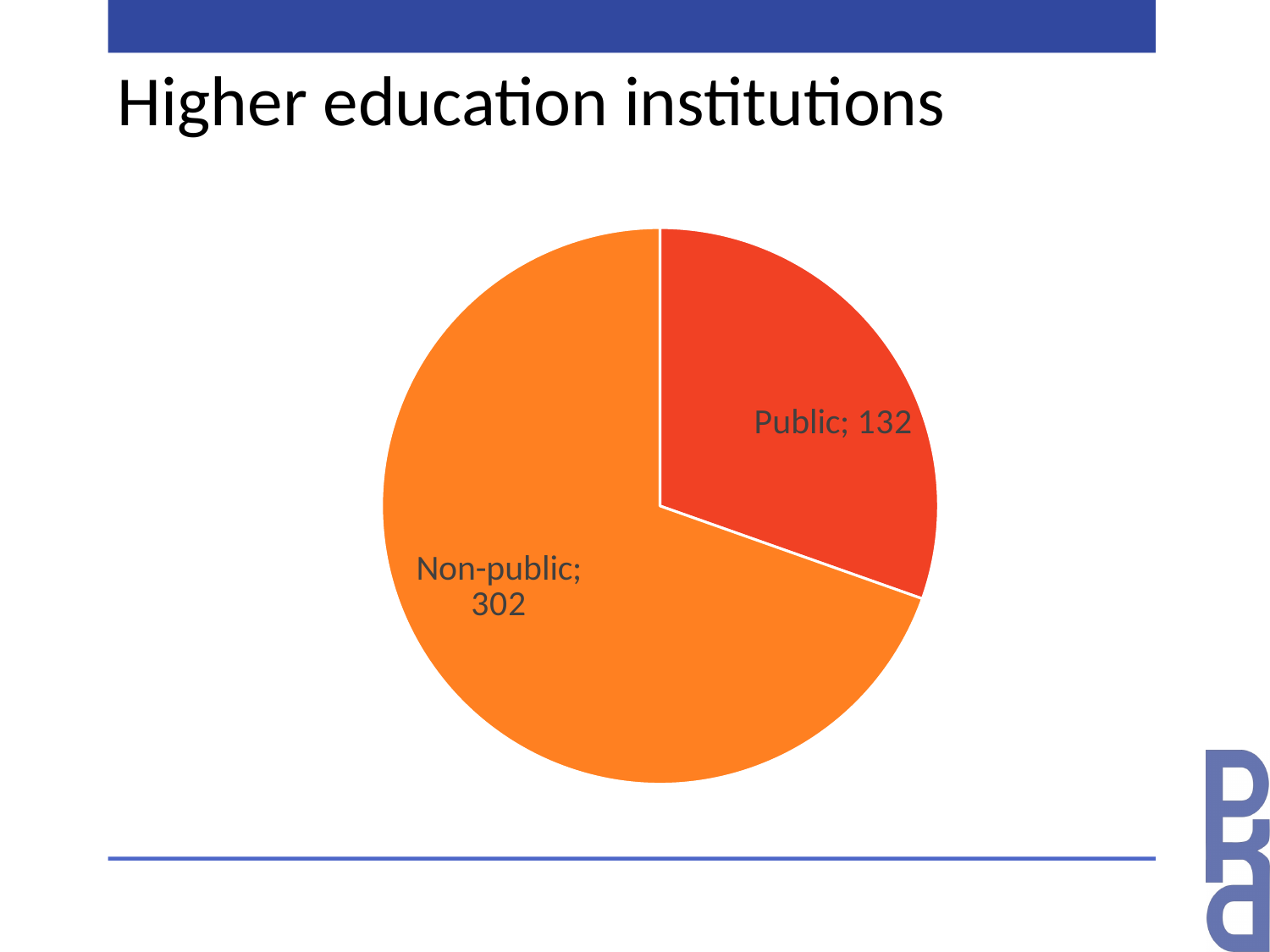
Which category has the largest slice? Non-public What is the title of the slide containing the chart? Higher education institutions What is the value for Non-public? 302 What colour is the Public slice? Red What is the total of all slices in the pie chart? 434 What is the difference between the Non-public and Public values? 170 What kind of chart is shown on the slide? Pie chart How many slices does the pie chart have? 2 What is the value for Public? 132 Which is larger, Public or Non-public? Non-public Which category has the smallest slice? Public